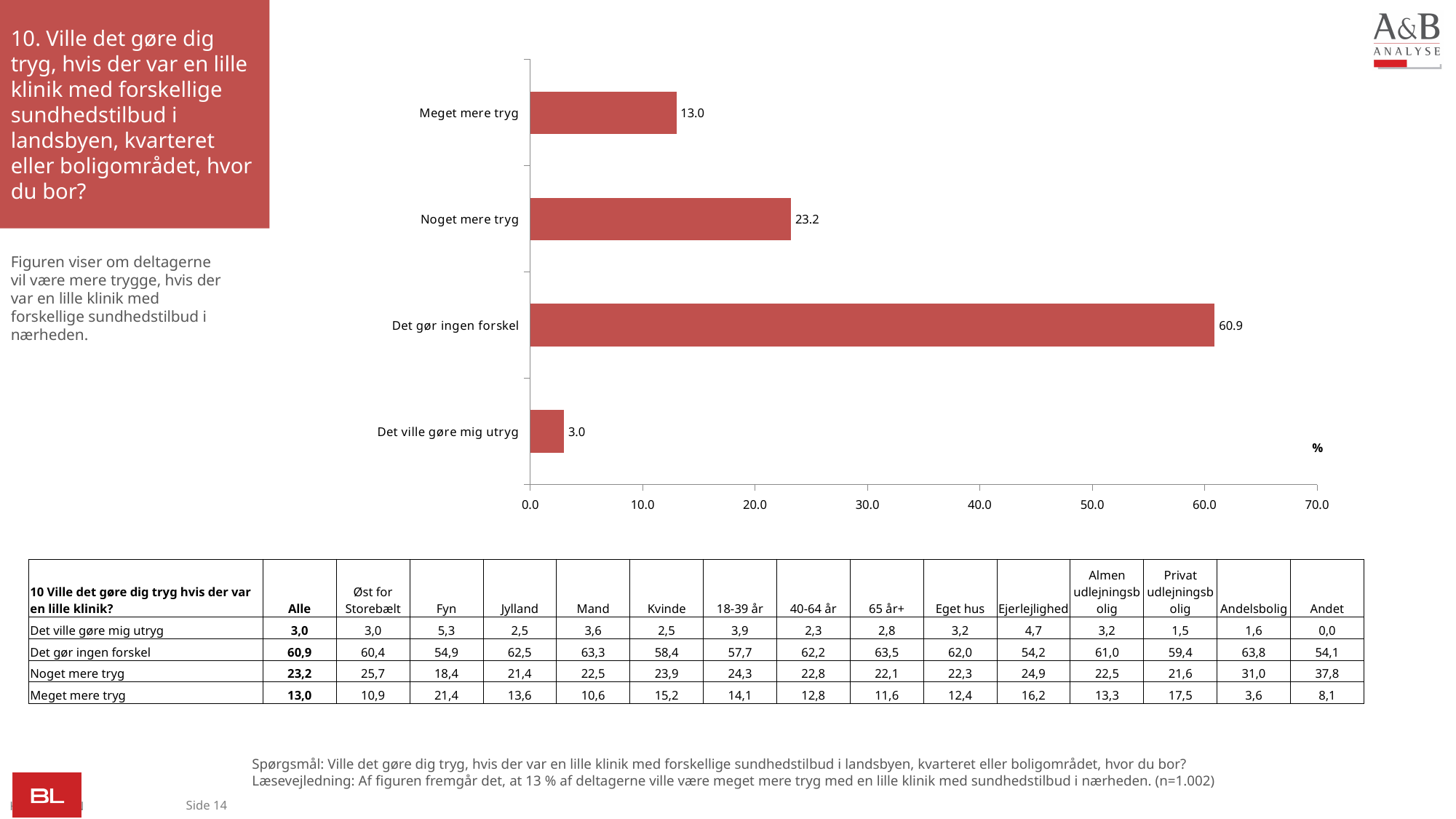
What is the value for "Noget mere tryg"? 23.2 Which is larger, the value for "Meget mere tryg" or the value for "Noget mere tryg"? Noget mere tryg How many categories are shown in the chart? 4 What is the maximum value shown on the x axis of the chart? 70.0 What kind of chart is shown on the slide? bar chart Which category has the lowest value? Det ville gøre mig utryg What is the value for "Meget mere tryg"? 13.0 What is the value for "Det gør ingen forskel"? 60.9 What is the difference between the values for "Noget mere tryg" and "Meget mere tryg"? 10.2 Which category has the highest value? Det gør ingen forskel Is the value for "Det gør ingen forskel" greater or less than 50.0? greater What is the value for "Det ville gøre mig utryg"? 3.0